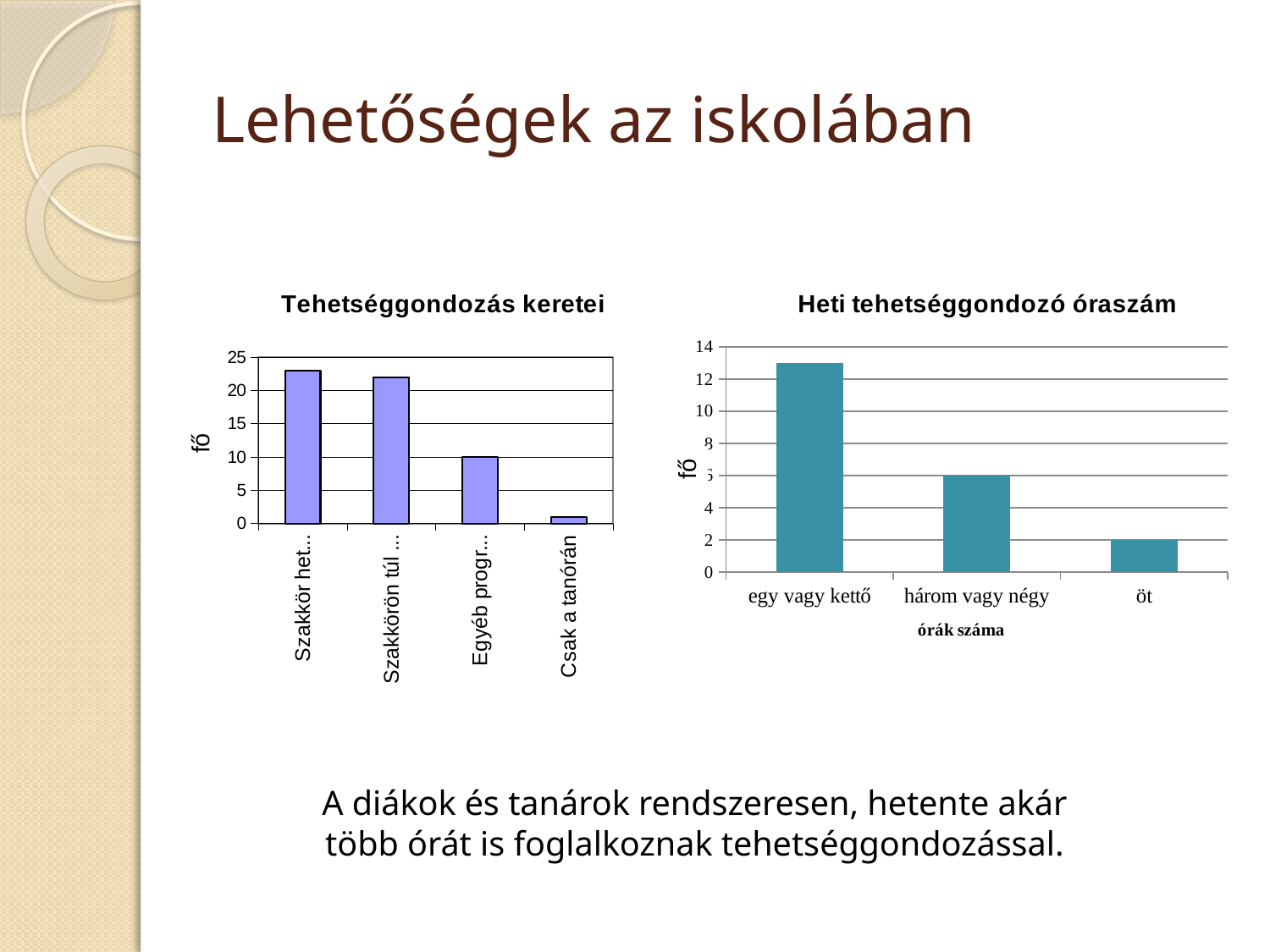
In the chart 'Heti tehetséggondozó óraszám', how many categories are shown on the x axis? 3 In the chart 'Heti tehetséggondozó óraszám', which category has the lowest value? öt In the chart 'Heti tehetséggondozó óraszám', which category has the highest value? egy vagy kettő In the chart 'Tehetséggondozás keretei', how many bars are shown? 4 In the chart 'Heti tehetséggondozó óraszám', what is the value for 'öt'? 2 In the chart 'Tehetséggondozás keretei', is the value for 'Csak a tanórán' greater or less than 5? less In the chart 'Heti tehetséggondozó óraszám', what is the title of the x axis? órák száma What kind of chart is 'Heti tehetséggondozó óraszám'? bar chart In the chart 'Heti tehetséggondozó óraszám', do the values rise or fall from left to right along the x axis? fall In the chart 'Tehetséggondozás keretei', what is the label on the y axis? fő In the chart 'Tehetséggondozás keretei', which category has the lowest value? Csak a tanórán In the chart 'Heti tehetséggondozó óraszám', is the value for 'egy vagy kettő' greater or less than 12? greater